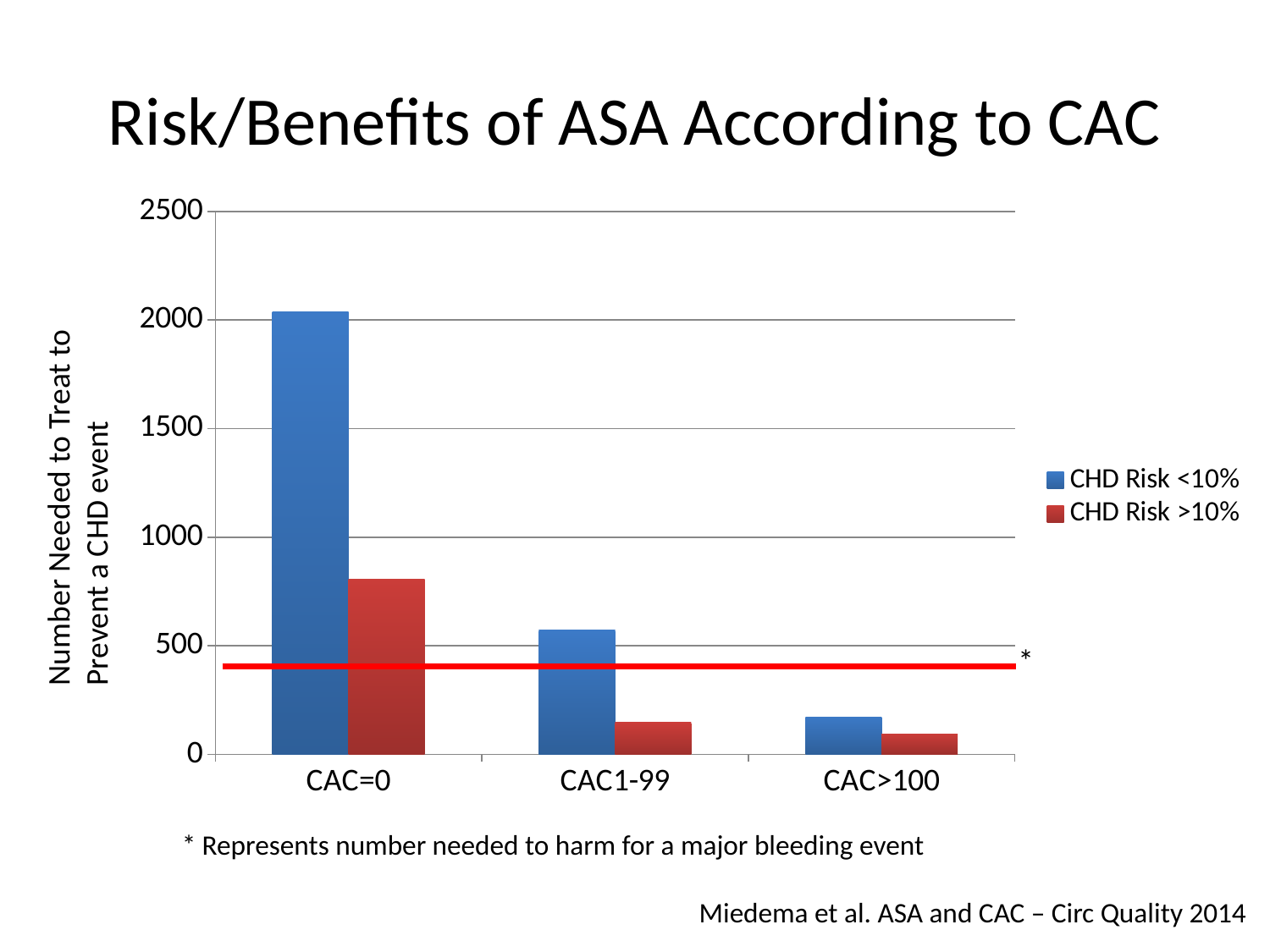
Is the value for CHD Risk <10% at CAC=0 greater or less than 2000? greater Is the value for CHD Risk <10% at CAC1-99 greater or less than 500? greater How many CAC categories are shown on the x axis? 3 Which is larger at CAC1-99: the value for CHD Risk <10% or CHD Risk >10%? CHD Risk <10% What is the title of the chart on the slide? Risk/Benefits of ASA According to CAC Do the values for CHD Risk <10% rise or fall from CAC=0 to CAC>100? fall Is the value for CHD Risk <10% at CAC>100 greater or less than 500? less How many series does the legend list? 2 Which CAC category has the highest value for CHD Risk <10%? CAC=0 Which CAC category has the lowest value for CHD Risk >10%? CAC>100 What kind of chart is shown on the slide? bar chart